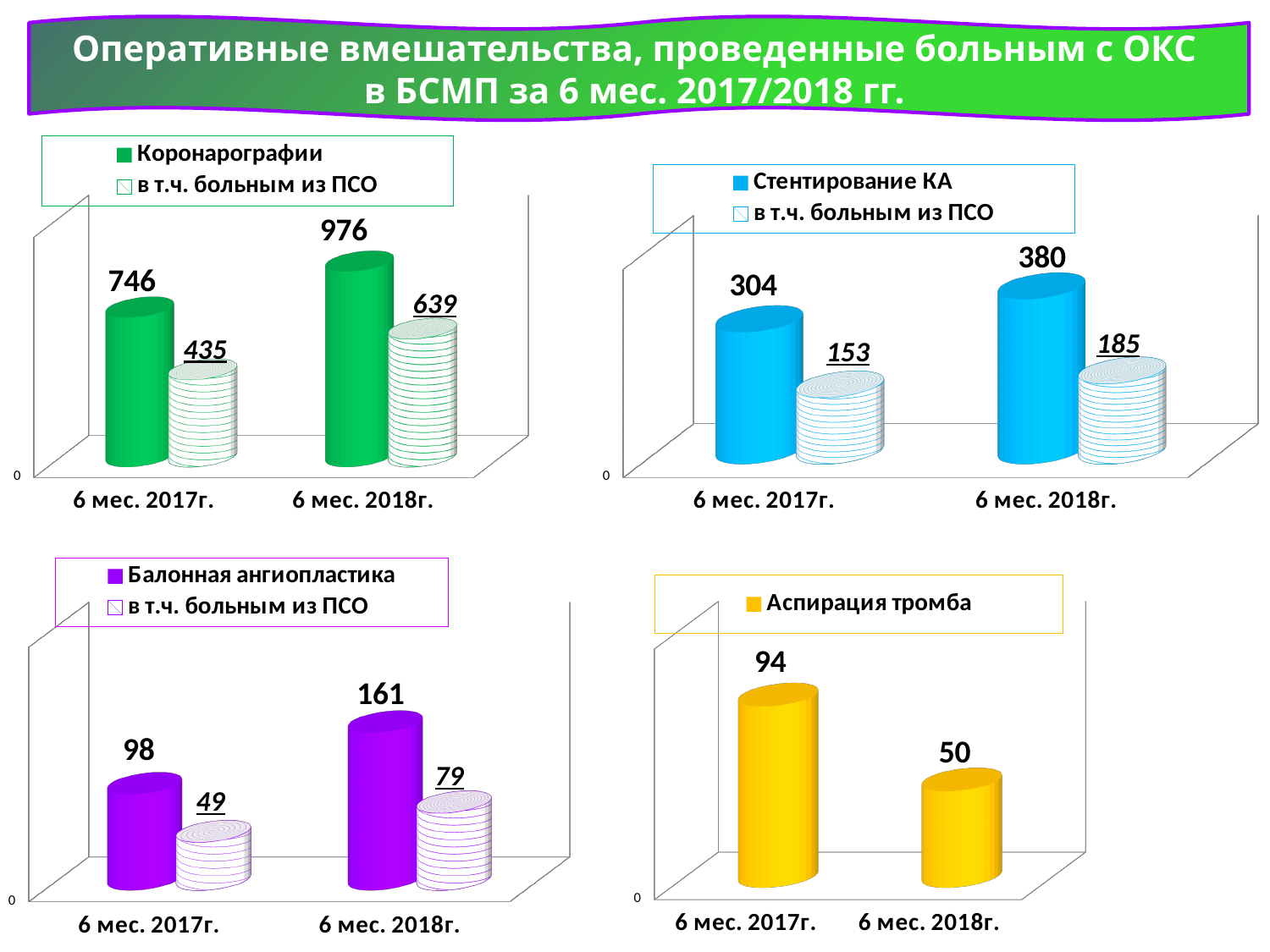
In the Коронарографии chart, by how much did Коронарографии increase from 6 мес. 2017г. to 6 мес. 2018г.? 230 In the Коронарографии chart, what is the value for Коронарографии in 6 мес. 2018г.? 976 In the Балонная ангиопластика chart, which period has the higher value for в т.ч. больным из ПСО, 6 мес. 2017г. or 6 мес. 2018г.? 6 мес. 2018г. What kind of chart is the Стентирование КА chart? bar chart In the Аспирация тромба chart, do the values rise or fall from 6 мес. 2017г. to 6 мес. 2018г.? fall In the Стентирование КА chart, what is the difference between Стентирование КА and в т.ч. больным из ПСО in 6 мес. 2018г.? 195 In the Стентирование КА chart, what is the value for Стентирование КА in 6 мес. 2017г.? 304 In the Балонная ангиопластика chart, what is the value for Балонная ангиопластика in 6 мес. 2018г.? 161 In the Аспирация тромба chart, what is the value for 6 мес. 2017г.? 94 How many series does the legend of the Аспирация тромба chart list? 1 In the Стентирование КА chart, what is the value for в т.ч. больным из ПСО in 6 мес. 2018г.? 185 In the Коронарографии chart, what is the value for в т.ч. больным из ПСО in 6 мес. 2017г.? 435